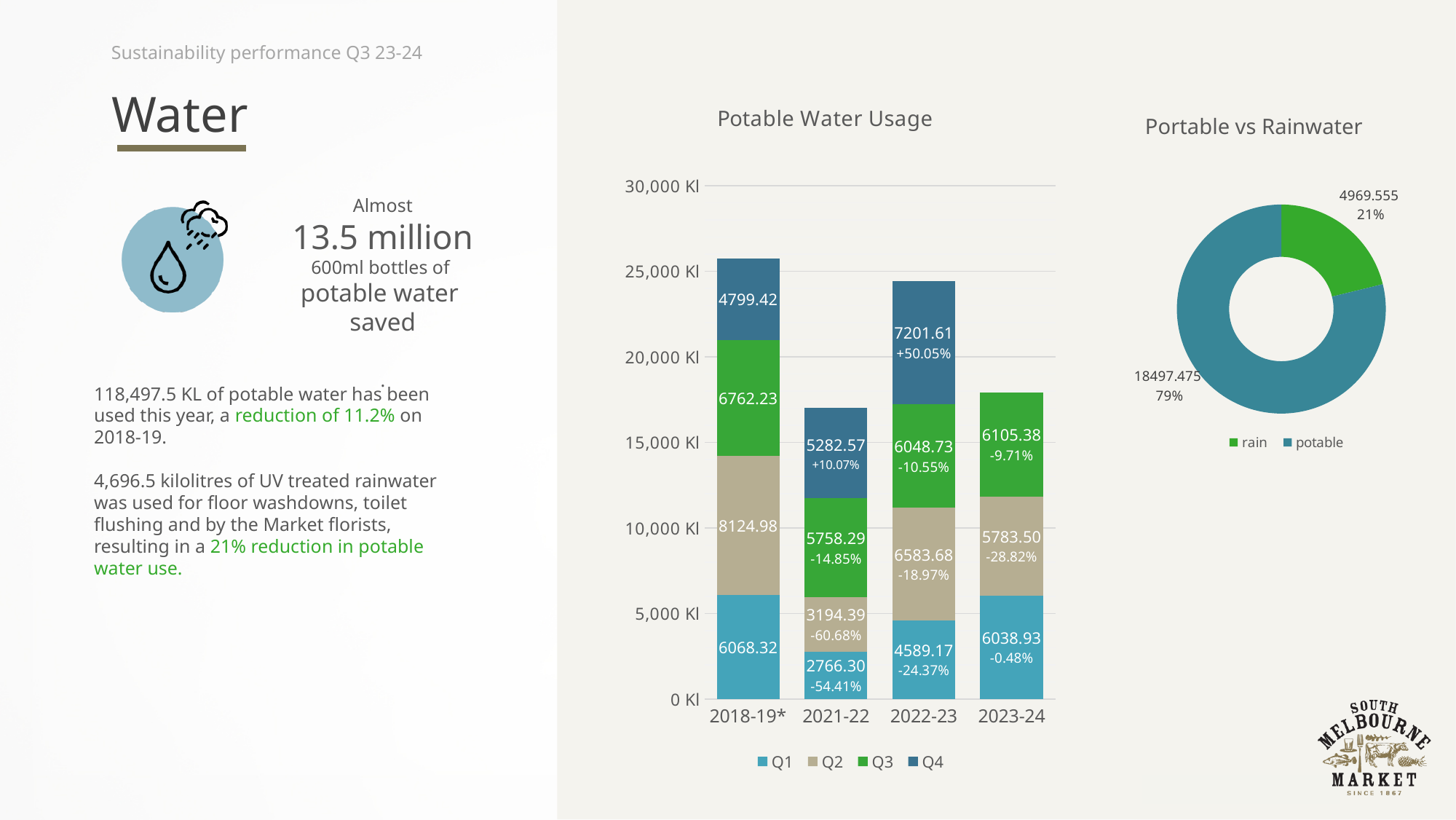
In the Potable Water Usage chart, which year has the highest Q4 value? 2022-23 In the Potable Water Usage chart, what is the difference between the Q3 value for 2023-24 and the Q3 value for 2022-23? 56.65 How many series does the legend of the Potable Water Usage chart list? 4 In the Portable vs Rainwater chart, what is the value for potable? 18497.475 In the Potable Water Usage chart, which is larger: the Q2 value for 2022-23 or the Q2 value for 2023-24? 2022-23 In the Potable Water Usage chart, what is the Q2 value for 2018-19*? 8124.98 In the Potable Water Usage chart, which year has the lowest Q1 value? 2021-22 How many years are shown on the x axis of the Potable Water Usage chart? 4 What kind of chart is the Potable Water Usage chart? Stacked bar chart In the Portable vs Rainwater chart, what share does rain represent? 21% In the Potable Water Usage chart, what is the total of the stacked bar for 2021-22? 17001.55 In the Potable Water Usage chart, what is the Q4 value for 2022-23? 7201.61